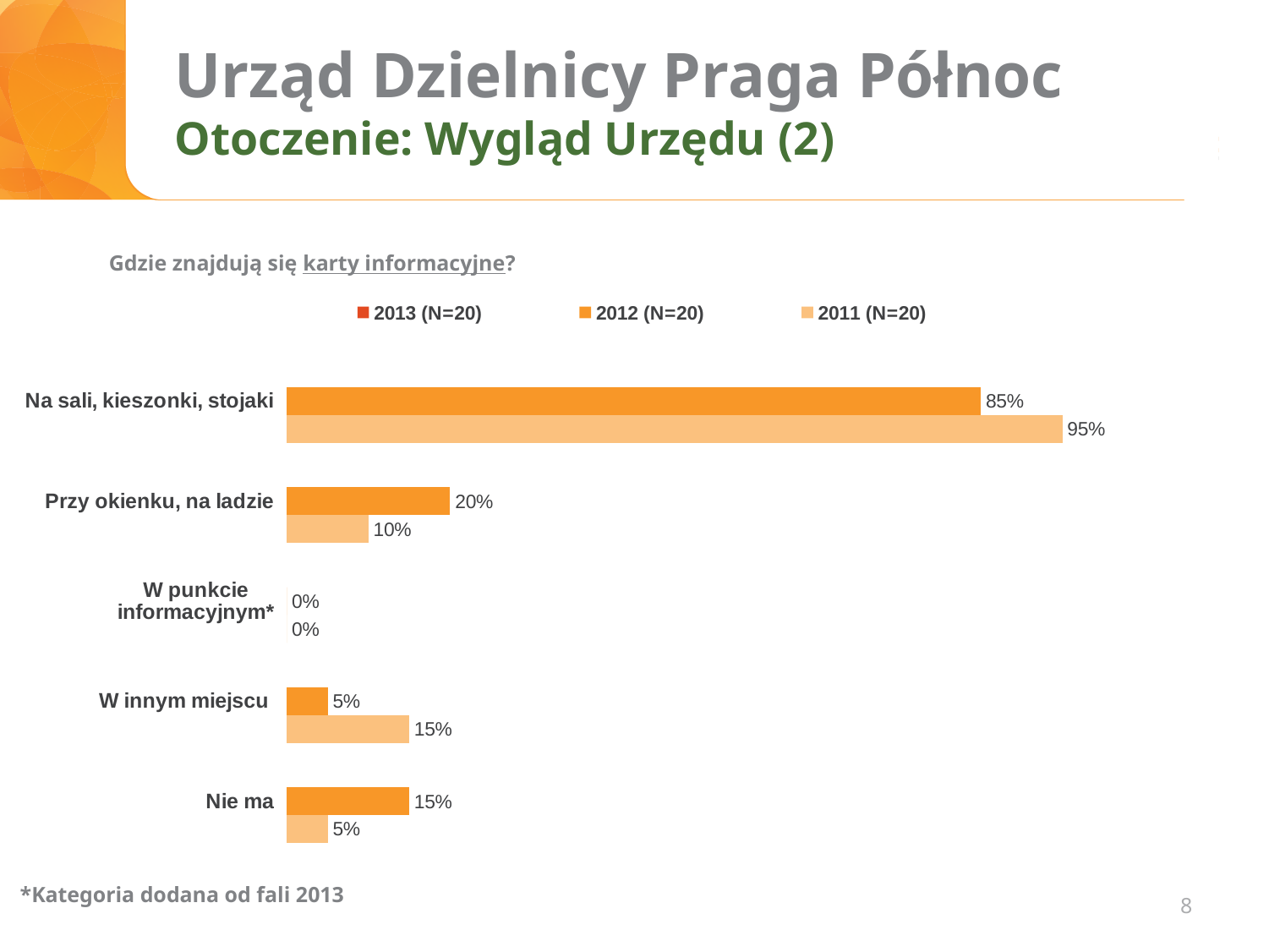
What type of chart is shown on the slide? bar chart What is the difference between the 2012 (N=20) and 2011 (N=20) values for 'Przy okienku, na ladzie'? 10% What is the value for 'Na sali, kieszonki, stojaki' in the 2012 (N=20) series? 85% What is the value for 'Na sali, kieszonki, stojaki' in the 2011 (N=20) series? 95% What is the value for 'Nie ma' in the 2011 (N=20) series? 5% Which category has the highest value in the 2011 (N=20) series? Na sali, kieszonki, stojaki What is the value for 'Przy okienku, na ladzie' in the 2012 (N=20) series? 20% What is the difference between the 2011 (N=20) and 2012 (N=20) values for 'Na sali, kieszonki, stojaki'? 10% How many series does the legend list? 3 What question does the chart title ask? Gdzie znajdują się karty informacyjne? How many categories are shown on the chart? 5 For 'W innym miejscu', which series has the larger value, 2012 (N=20) or 2011 (N=20)? 2011 (N=20)